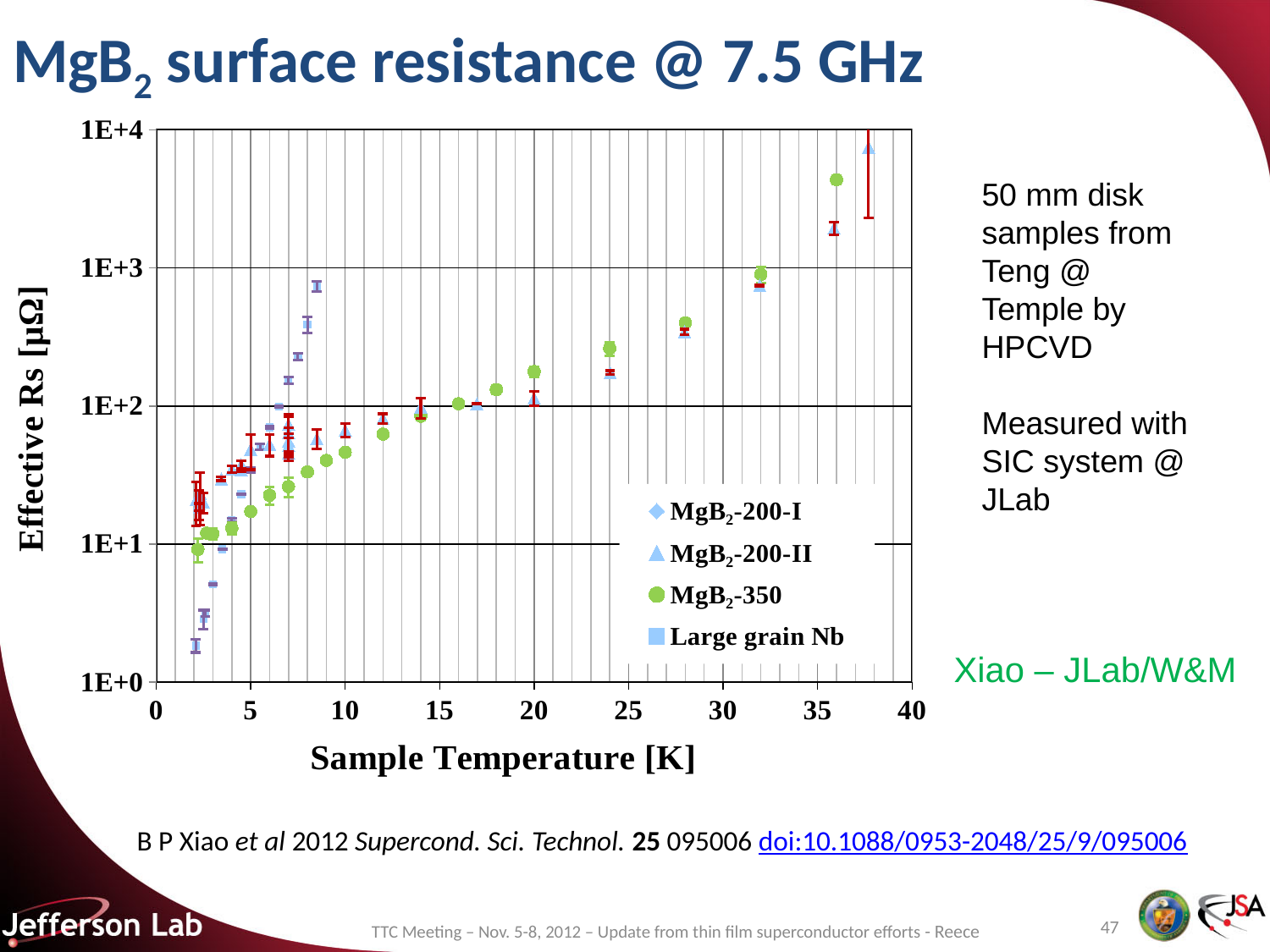
Is the value for MgB2-350 at 36 K greater or less than 1E+3? greater Is the value for Large grain Nb at 2 K greater or less than 1E+1? less At 8 K, which series has the larger value: Large grain Nb or MgB2-350? Large grain Nb Is the value for Large grain Nb at 8 K greater or less than 1E+2? greater How many series does the chart legend list? 4 What kind of chart is shown on the slide? scatter chart What is the label of the x axis of the chart? Sample Temperature [K] Do the MgB2-350 values rise or fall as sample temperature increases from 10 K to 36 K? rise What is the label of the y axis of the chart? Effective Rs [μΩ]